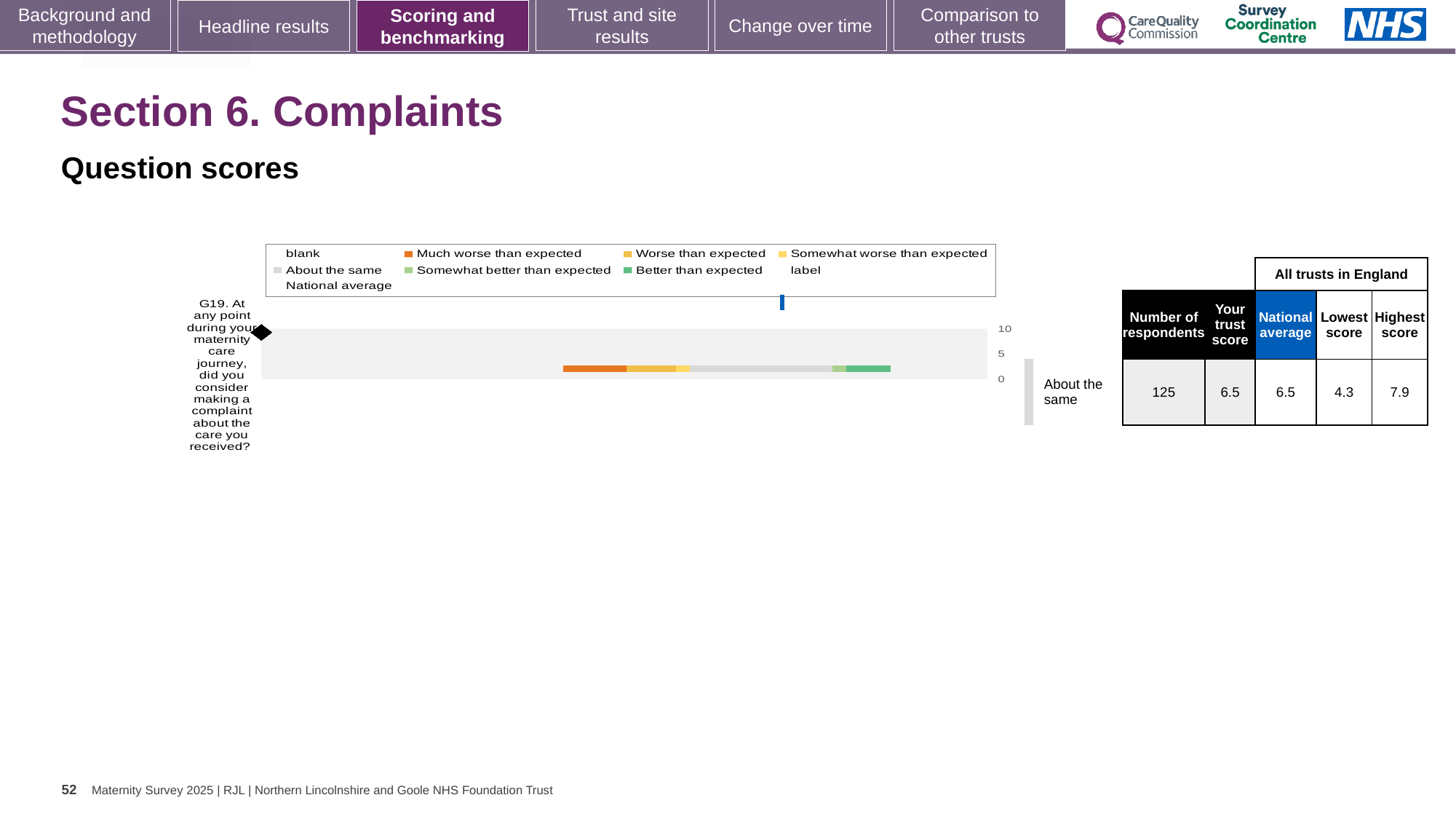
What is the number of respondents for question G19? 125 What is the lowest score among all trusts in England for question G19? 4.3 How many survey questions are plotted in the chart? 1 What is the trust's score for question G19? 6.5 Is the trust's score for question G19 greater or less than 5? greater What colour represents 'Much worse than expected' in the chart legend? orange What is the difference between the trust's score and the national average for question G19? 0 What kind of chart is shown on the slide? bar chart What is the highest score among all trusts in England for question G19? 7.9 Which benchmark category is the trust's result for question G19 placed in? About the same What is the national average score for question G19? 6.5 What is the difference between the highest and lowest scores for question G19? 3.6